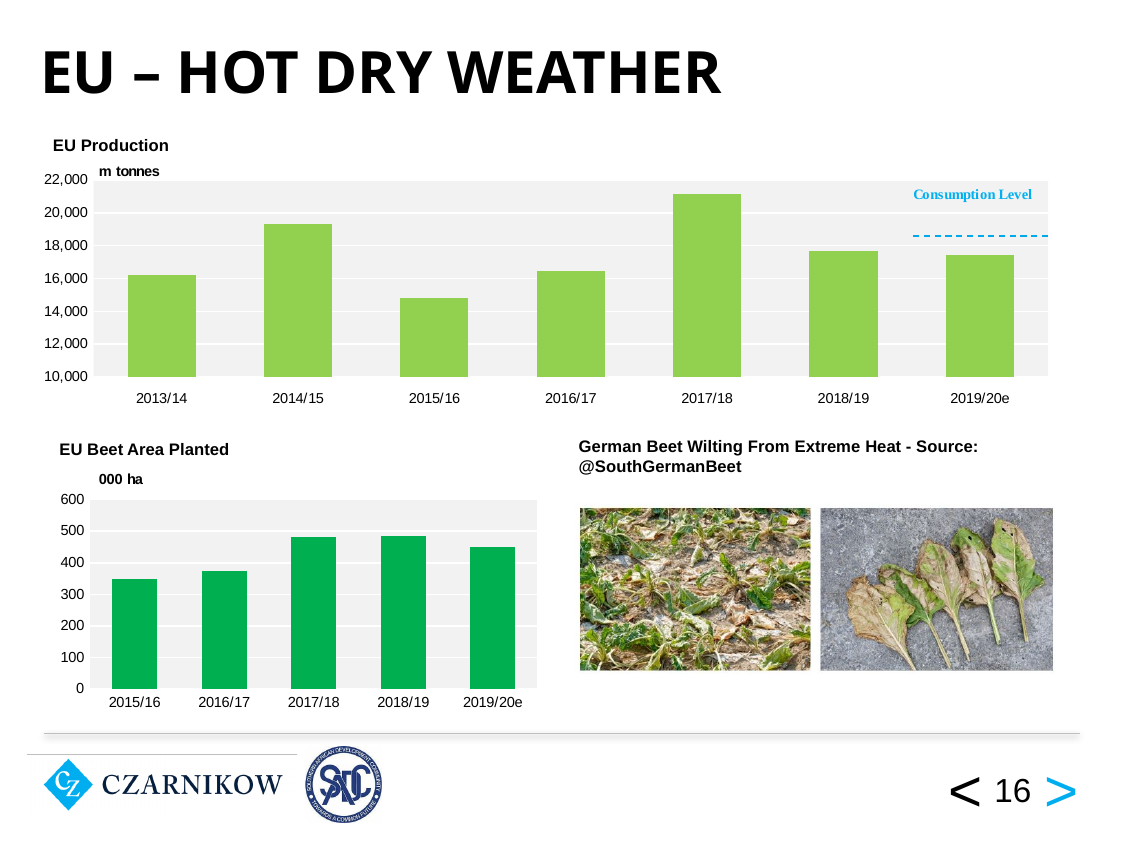
In the EU Production chart, is the value for 2015/16 greater or less than 16,000? less What type of chart is the EU Beet Area Planted chart? bar chart In the EU Production chart, which season has the lowest production? 2015/16 In the EU Production chart, which season has the highest production? 2017/18 In the EU Production chart, which is larger, the value for 2013/14 or 2014/15? 2014/15 In the EU Beet Area Planted chart, which is larger, the value for 2016/17 or 2017/18? 2017/18 What unit is shown on the EU Production chart? m tonnes In the EU Beet Area Planted chart, which season has the lowest area planted? 2015/16 In the EU Production chart, is the value for 2014/15 greater or less than 18,000? greater How many seasons are shown in the EU Production chart? 7 In the EU Beet Area Planted chart, is the value for 2017/18 greater or less than 400? greater